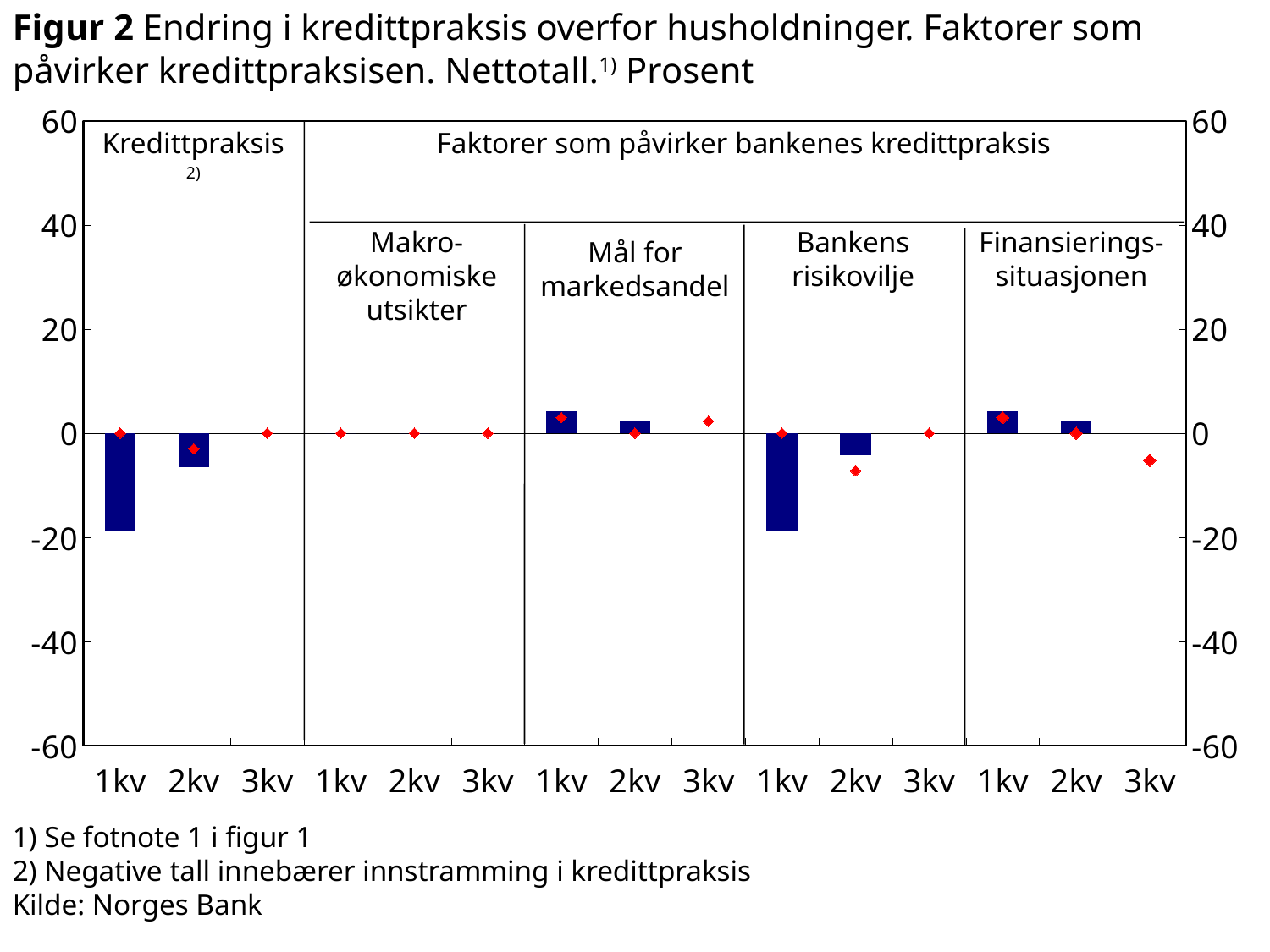
In the Kredittpraksis panel, which quarter has the lowest bar? 1kv How many quarters (1kv, 2kv, 3kv) are shown in each panel of the chart? 3 In the Kredittpraksis panel, do the bars rise or fall from 1kv to 3kv? rise In the Bankens risikovilje panel, is the bar for 1kv greater or less than -10? less In the Kredittpraksis panel, which bar is larger, 1kv or 2kv? 2kv In the Kredittpraksis panel, is the bar for 1kv greater or less than -10? less What is the highest value shown on the y axis? 60 In the Mål for markedsandel panel, is the bar for 1kv greater or less than 0? greater What source is given for the chart? Norges Bank How many factors are listed under 'Faktorer som påvirker bankenes kredittpraksis'? 4 What kind of chart is shown on the slide? bar chart